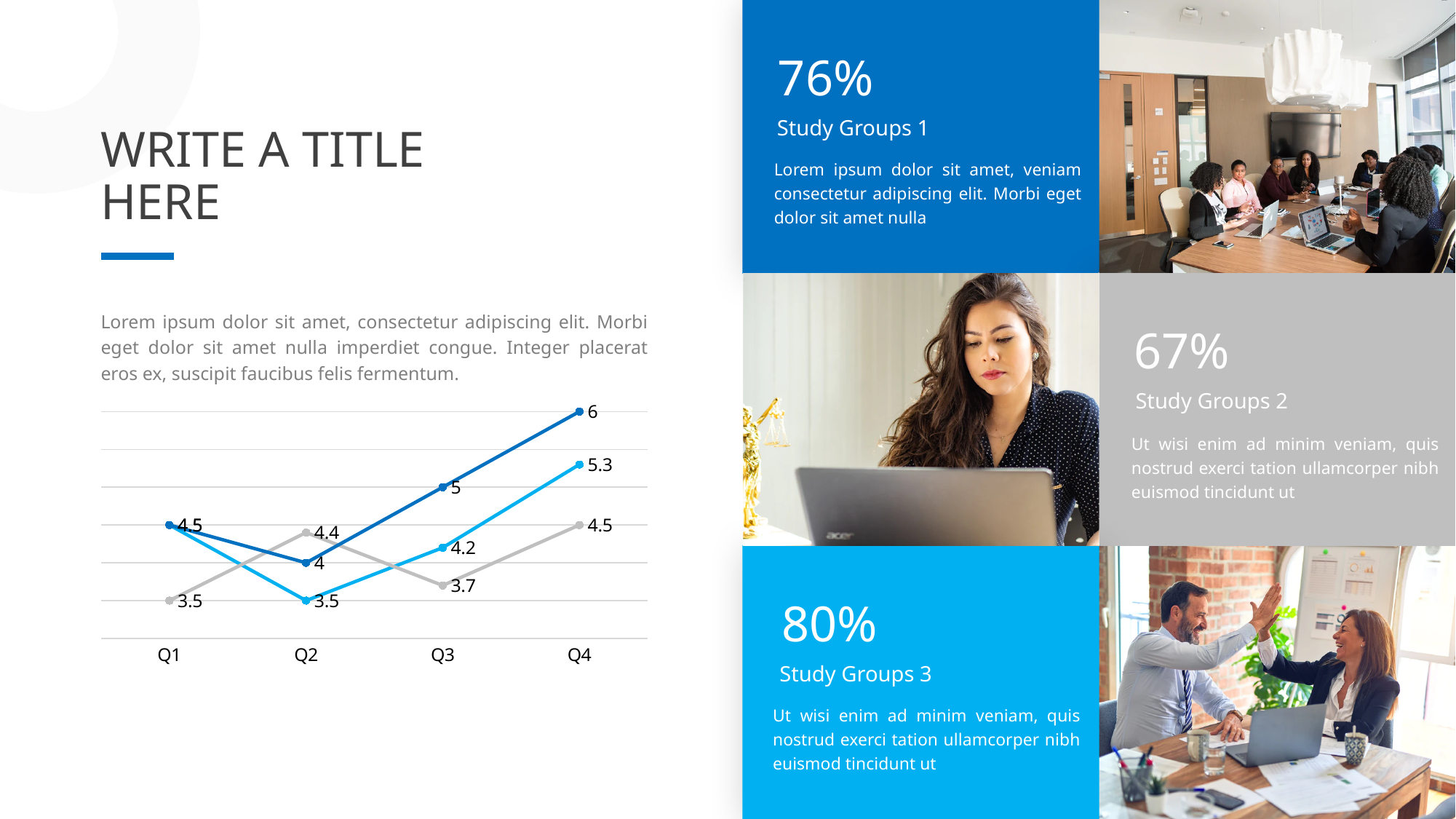
What is the value of the light blue line at Q3? 4.2 What is the difference between the dark blue line and the light blue line at Q4? 0.7 What kind of chart is shown on the slide? line chart At which quarter does the gray line have its lowest value? Q1 At Q3, which line has the larger value, the dark blue line or the gray line? dark blue line How many lines are plotted on the line chart? 3 At which quarter does the dark blue line reach its highest value? Q4 What is the value of the gray line at Q2? 4.4 Does the dark blue line rise or fall from Q2 to Q4? rise How many categories are shown on the x axis of the line chart? 4 What is the value of the light blue line at Q2? 3.5 What is the value of the dark blue line at Q4? 6